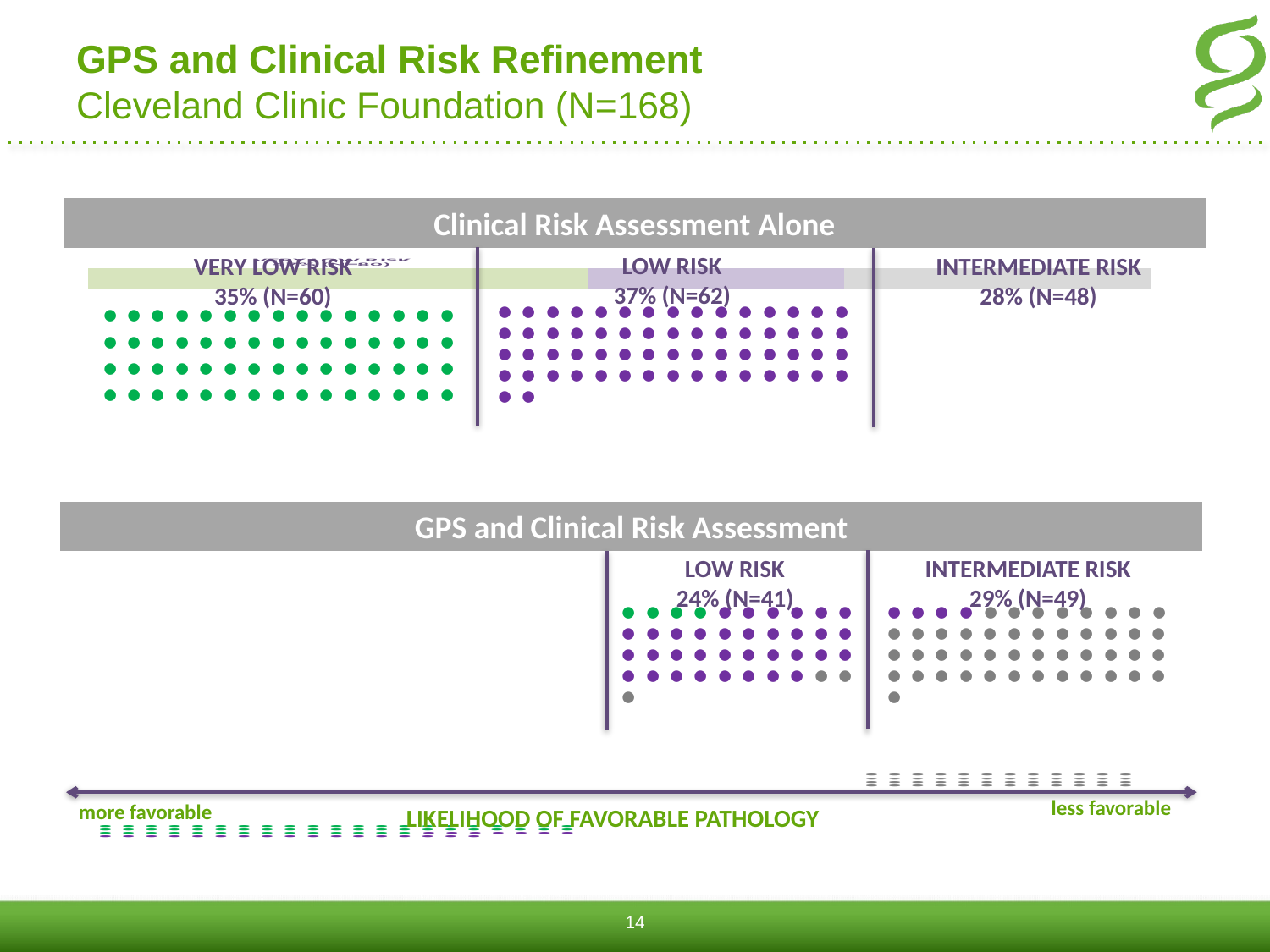
In the GPS and Clinical Risk Assessment chart, what percentage of patients are in the Low Risk group? 24% What is the total number of patients (N) in the study shown on the slide? 168 In the Clinical Risk Assessment Alone chart, what percentage of patients are in the Very Low Risk group? 35% In the Clinical Risk Assessment Alone chart, which risk group has the smallest share of patients? Intermediate Risk What does the horizontal axis at the bottom of the slide represent? Likelihood of favorable pathology In the Clinical Risk Assessment Alone chart, which risk group has the largest share of patients? Low Risk In the GPS and Clinical Risk Assessment chart, how many patients (N) are in the Intermediate Risk group? 49 In the Clinical Risk Assessment Alone chart, what percentage of patients are in the Intermediate Risk group? 28% In the Clinical Risk Assessment Alone chart, how many patients (N) are in the Low Risk group? 62 In the GPS and Clinical Risk Assessment chart, which group has more patients, Low Risk or Intermediate Risk? Intermediate Risk In the Clinical Risk Assessment Alone chart, how many more patients are in the Low Risk group than in the Intermediate Risk group? 14 How many risk groups are labelled in the Clinical Risk Assessment Alone chart? 3